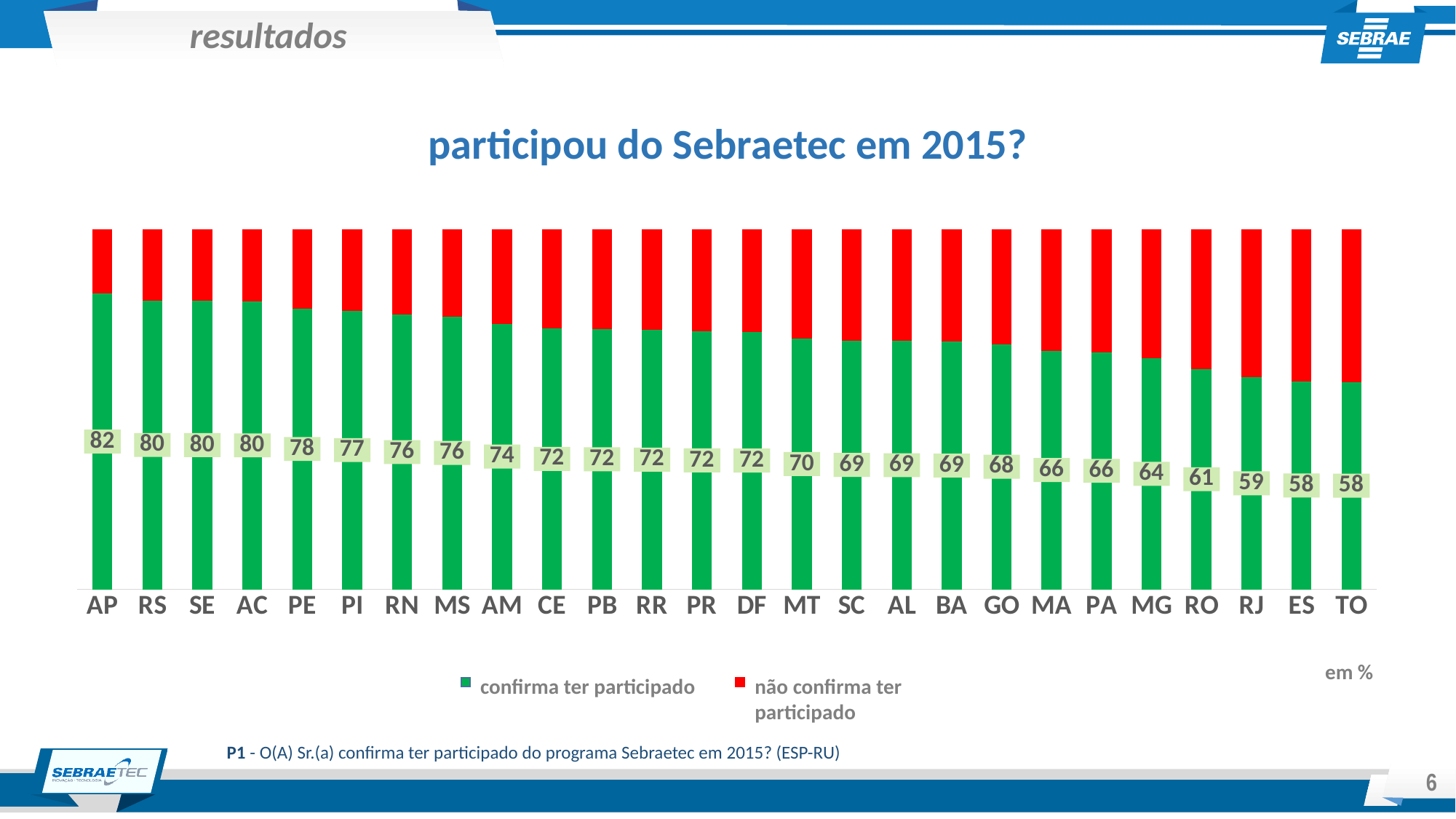
What is the value for 'confirma ter participado' for AP? 82 Which series is shown in red? não confirma ter participado How many states are shown on the x axis? 26 What is the value for 'confirma ter participado' for RO? 61 What is the difference between the 'confirma ter participado' values for RS and MG? 16 What kind of chart is shown on the slide? Stacked bar chart Which has a larger 'confirma ter participado' value, PE or MA? PE How many series does the legend list? 2 Do the 'confirma ter participado' values rise or fall from left to right along the x axis? Fall What is the difference between the 'confirma ter participado' values for AP and TO? 24 Which state has the highest value for 'confirma ter participado'? AP What is the value for 'confirma ter participado' for MG? 64